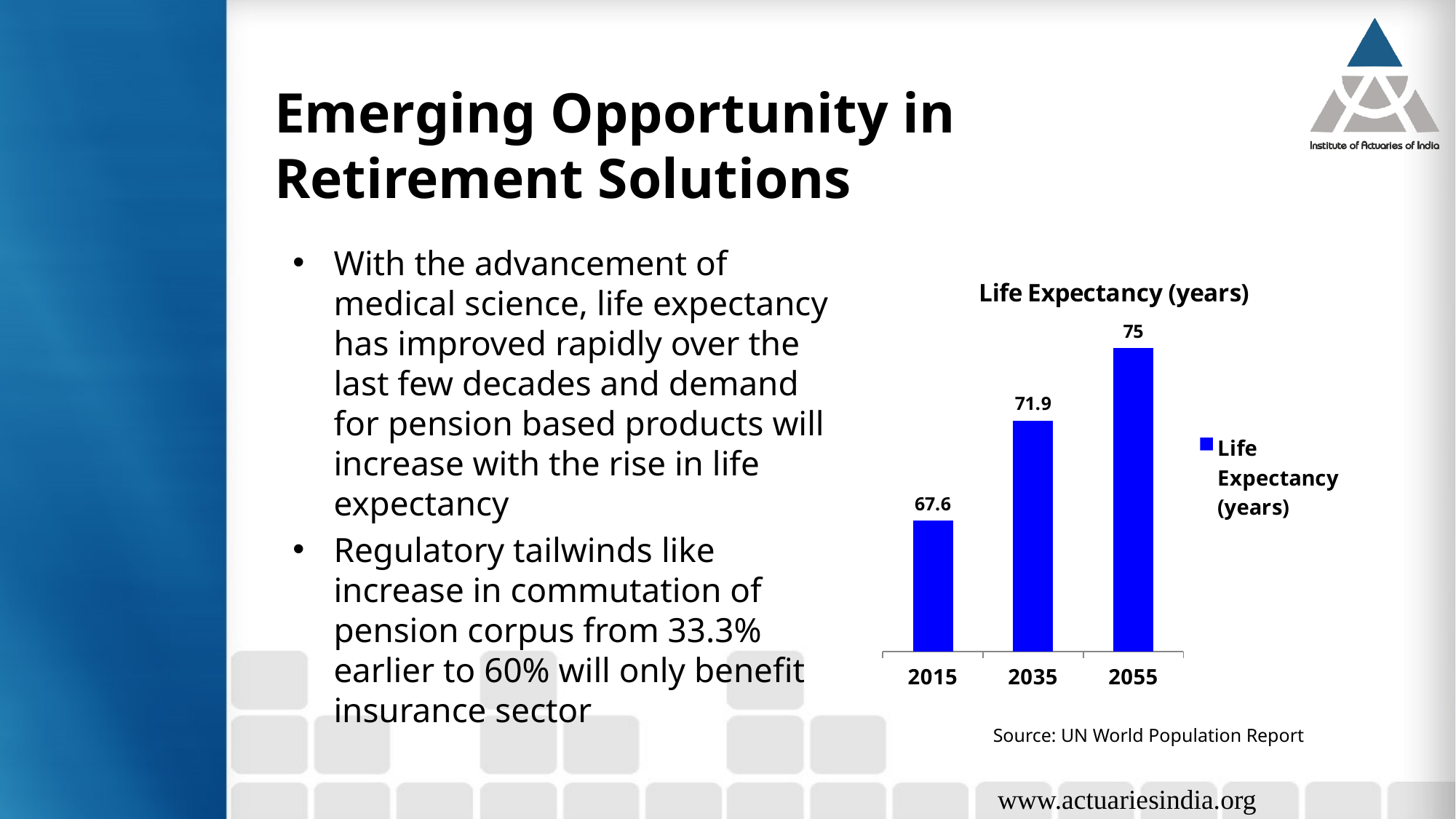
How many years (categories) are shown on the x axis of the chart? 3 Which year has the highest life expectancy in the chart? 2055 What is the difference between the life expectancy values for 2055 and 2015? 7.4 What is the life expectancy value shown for 2015? 67.6 What is the life expectancy value shown for 2055? 75 What is the difference between the life expectancy values for 2035 and 2015? 4.3 What kind of chart is shown on the slide? Bar chart Do the life expectancy values rise or fall from 2015 to 2055? Rise Which is larger, the life expectancy for 2035 or for 2055? 2055 How many series does the chart legend list? 1 Which year has the lowest life expectancy in the chart? 2015 What is the life expectancy value shown for 2035? 71.9